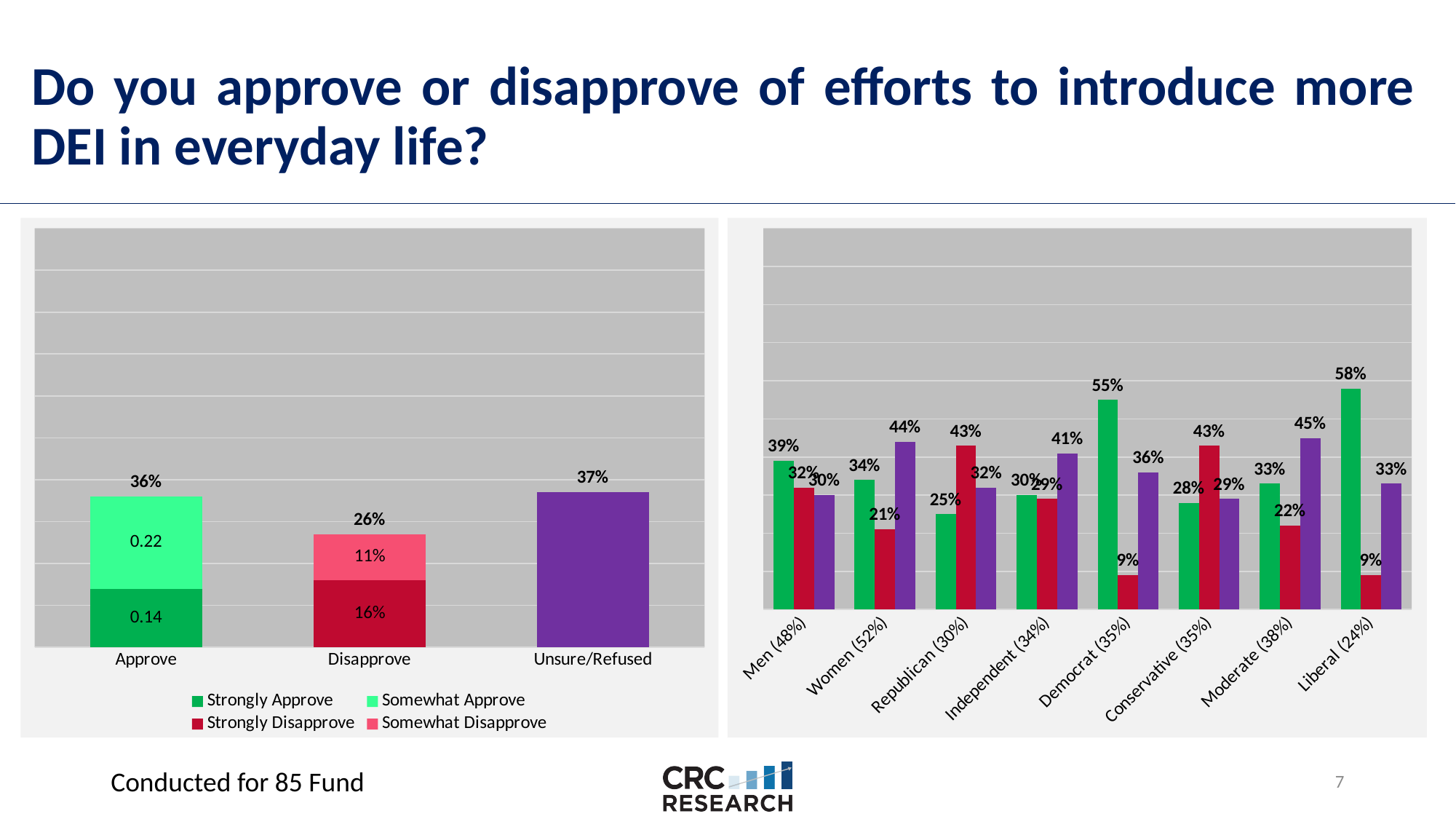
On the right chart, what is the value of the green bar for Liberal (24%)? 58% On the right chart, what is the value of the red bar for Democrat (35%)? 9% On the right chart, is the red bar for Republican (30%) larger or smaller than the red bar for Women (52%)? larger On the right chart, which group has the highest green bar? Liberal (24%) On the right chart, how many groups are shown on the x axis? 8 On the left chart, how many series does the legend list? 4 On the left chart, which category has the lowest total value? Disapprove On the left chart, what value is printed for the Strongly Disapprove segment of the Disapprove bar? 16% On the right chart, what is the value of the purple bar for Moderate (38%)? 45% On the left chart, what is the difference between the Approve total and the Disapprove total? 10% On the left chart, what value is printed for the Somewhat Approve segment of the Approve bar? 0.22 On the left chart, what is the total value shown for the Unsure/Refused bar? 37%